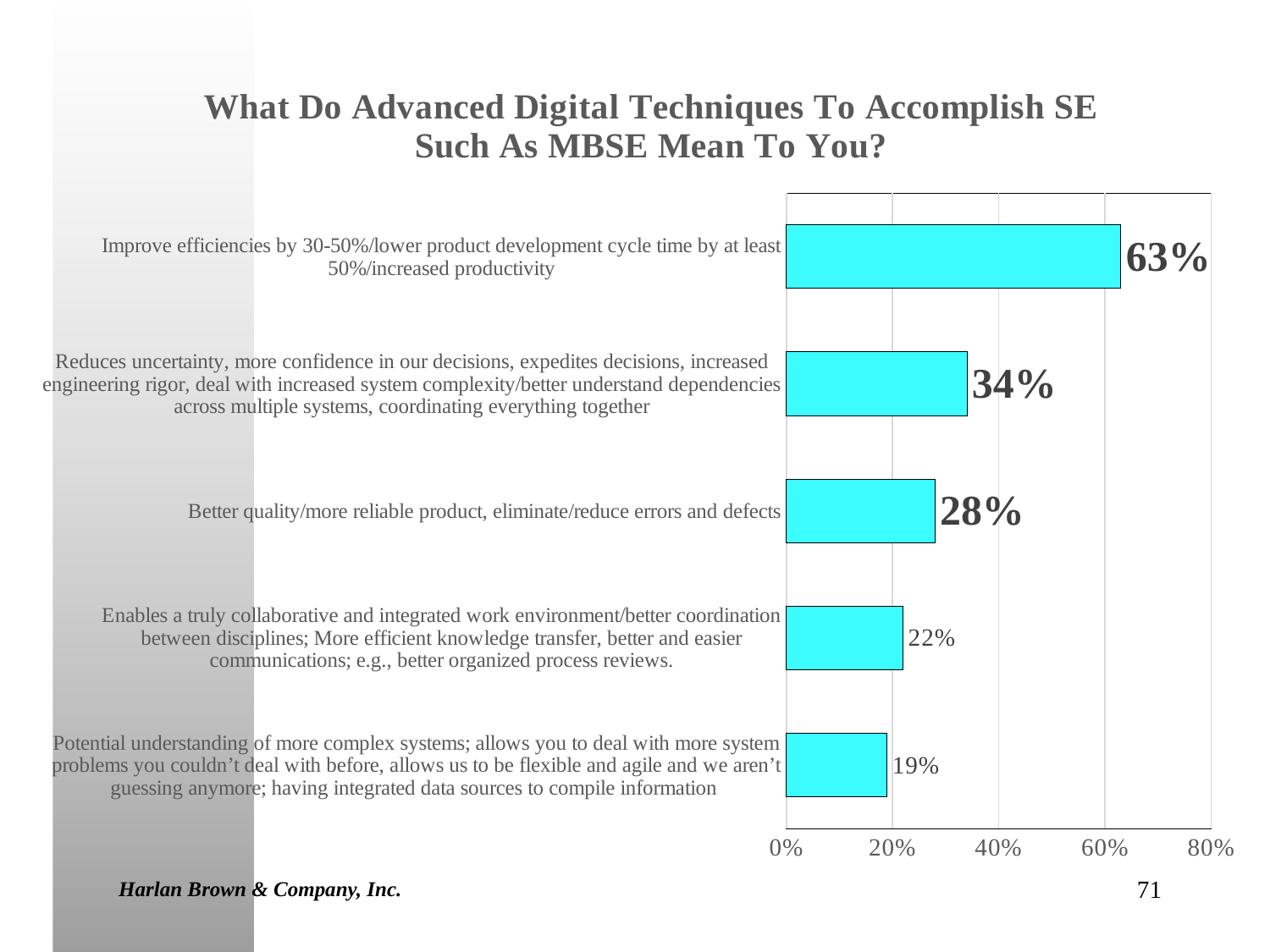
How many categories are plotted in the chart? 5 What is the difference between the highest value (63%) and the value for the category beginning 'Reduces uncertainty' (34%)? 29% What percentage is shown for the category beginning 'Enables a truly collaborative and integrated work environment'? 22% What percentage is shown for the category beginning 'Potential understanding of more complex systems'? 19% What kind of chart is shown on the slide? bar chart Is the value for the category beginning 'Reduces uncertainty' greater or less than 40%? less What is the title of the chart? What Do Advanced Digital Techniques To Accomplish SE Such As MBSE Mean To You? Which category has the highest value? Improve efficiencies by 30-50%/lower product development cycle time by at least 50%/increased productivity Which is larger: the value for 'Better quality/more reliable product' or the value for the category beginning 'Enables a truly collaborative'? Better quality/more reliable product, eliminate/reduce errors and defects What percentage is shown for 'Better quality/more reliable product, eliminate/reduce errors and defects'? 28% What value is shown for the category beginning 'Improve efficiencies by 30-50%'? 63%